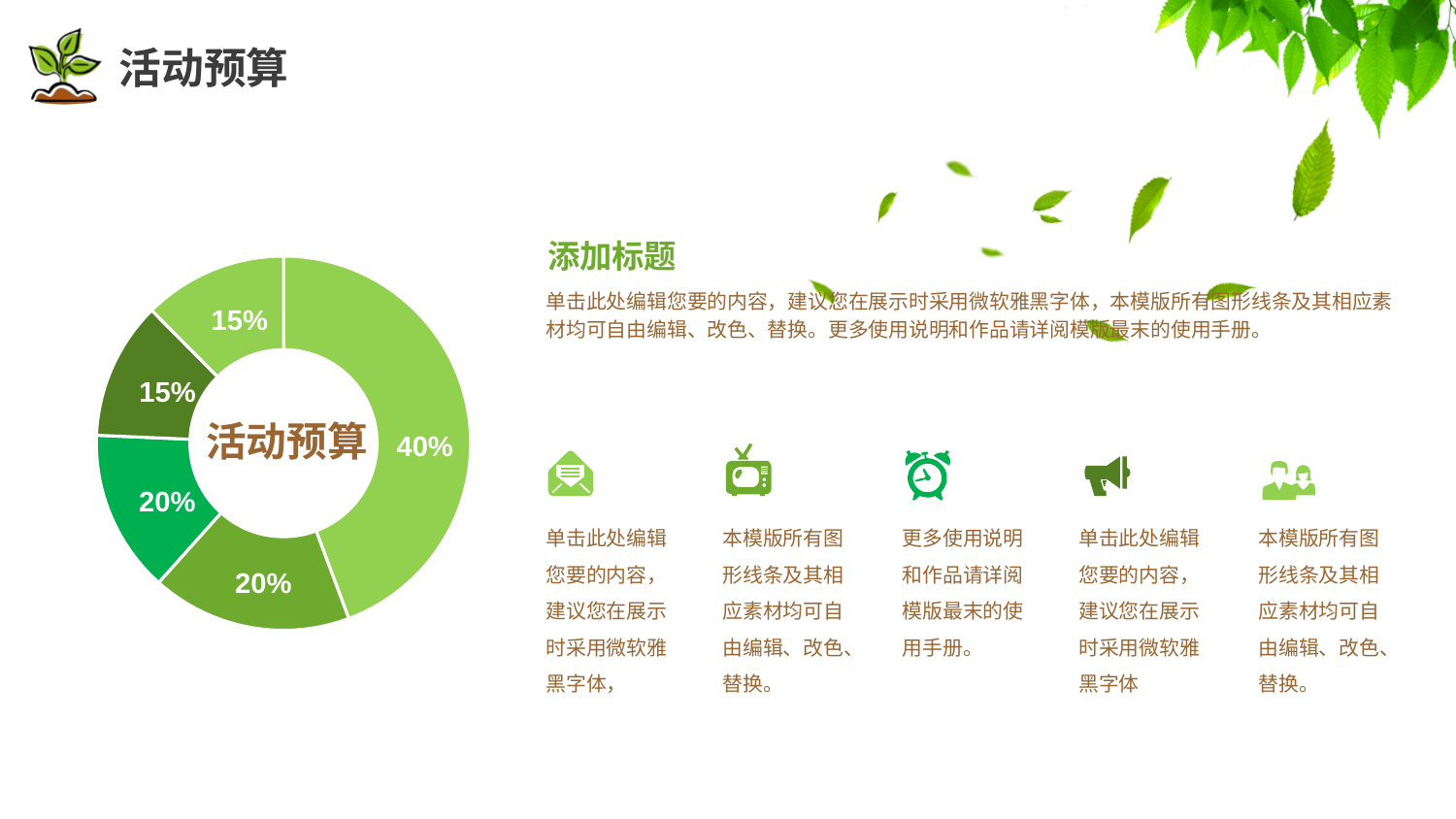
What text is written in the center of the doughnut chart? 活动预算 What is the difference between the largest slice (40%) and one of the smallest slices (15%)? 25% Do all the slice values in the doughnut chart add up to 100%? No Is the largest slice of the doughnut chart greater or less than 50%? less What is the value of the largest slice in the doughnut chart? 40% What kind of chart is shown on the slide? Doughnut (pie) chart What colour is the largest (40%) slice of the doughnut chart? Light green What is the combined share of the two slices labeled 20%? 40% How many slices in the doughnut chart are labeled 15%? 2 How many slices does the doughnut chart have? 5 What is the value of the smallest slices in the doughnut chart? 15% How many slices in the doughnut chart are labeled 20%? 2